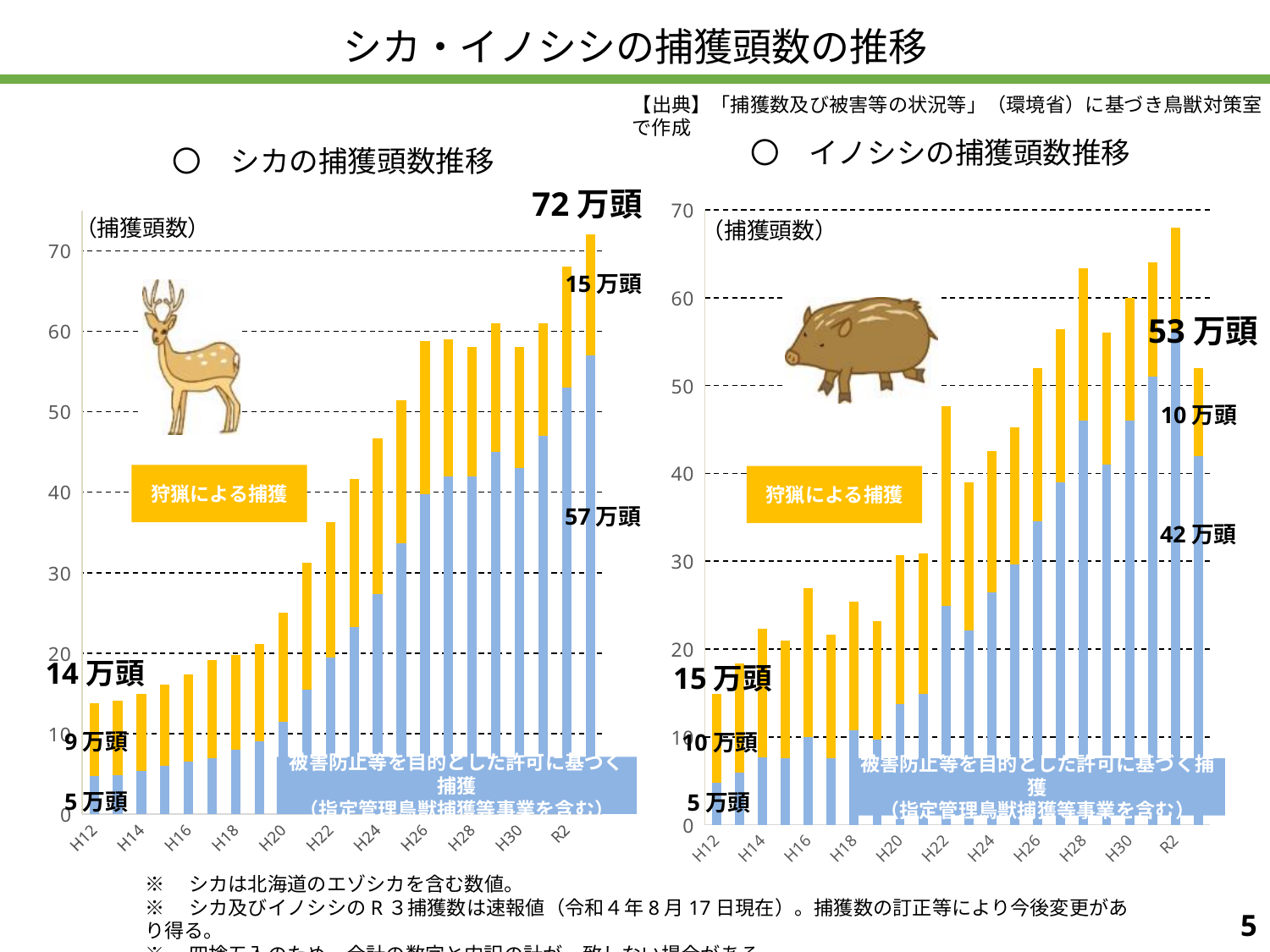
In the シカの捕獲頭数推移 chart, what total is labelled for H12? 14万頭 Which is larger: the labelled most recent total in the シカ chart or in the イノシシ chart? シカ (72万頭) In the シカの捕獲頭数推移 chart, by how much does the labelled most recent total (72万頭) exceed the labelled H12 total (14万頭)? 58万頭 In the イノシシの捕獲頭数推移 chart, what total is labelled for H12? 15万頭 In the イノシシの捕獲頭数推移 chart, what total is labelled on the most recent bar? 53万頭 What kind of chart is used for the シカの捕獲頭数推移 chart on the left? bar chart In the イノシシの捕獲頭数推移 chart, what value is labelled for 狩猟による捕獲 on the most recent bar? 10万頭 In the シカの捕獲頭数推移 chart, do the totals generally rise or fall from H12 to the most recent year? rise In the シカの捕獲頭数推移 chart, what total is labelled on the tallest (most recent) bar? 72万頭 In the シカの捕獲頭数推移 chart, what value is labelled for the permit-based capture (被害防止等を目的とした許可に基づく捕獲) on the most recent bar? 57万頭 In the シカの捕獲頭数推移 chart, what value is labelled for 狩猟による捕獲 on the most recent bar? 15万頭 In the シカの捕獲頭数推移 chart, is the total for H20 greater or less than 30? less